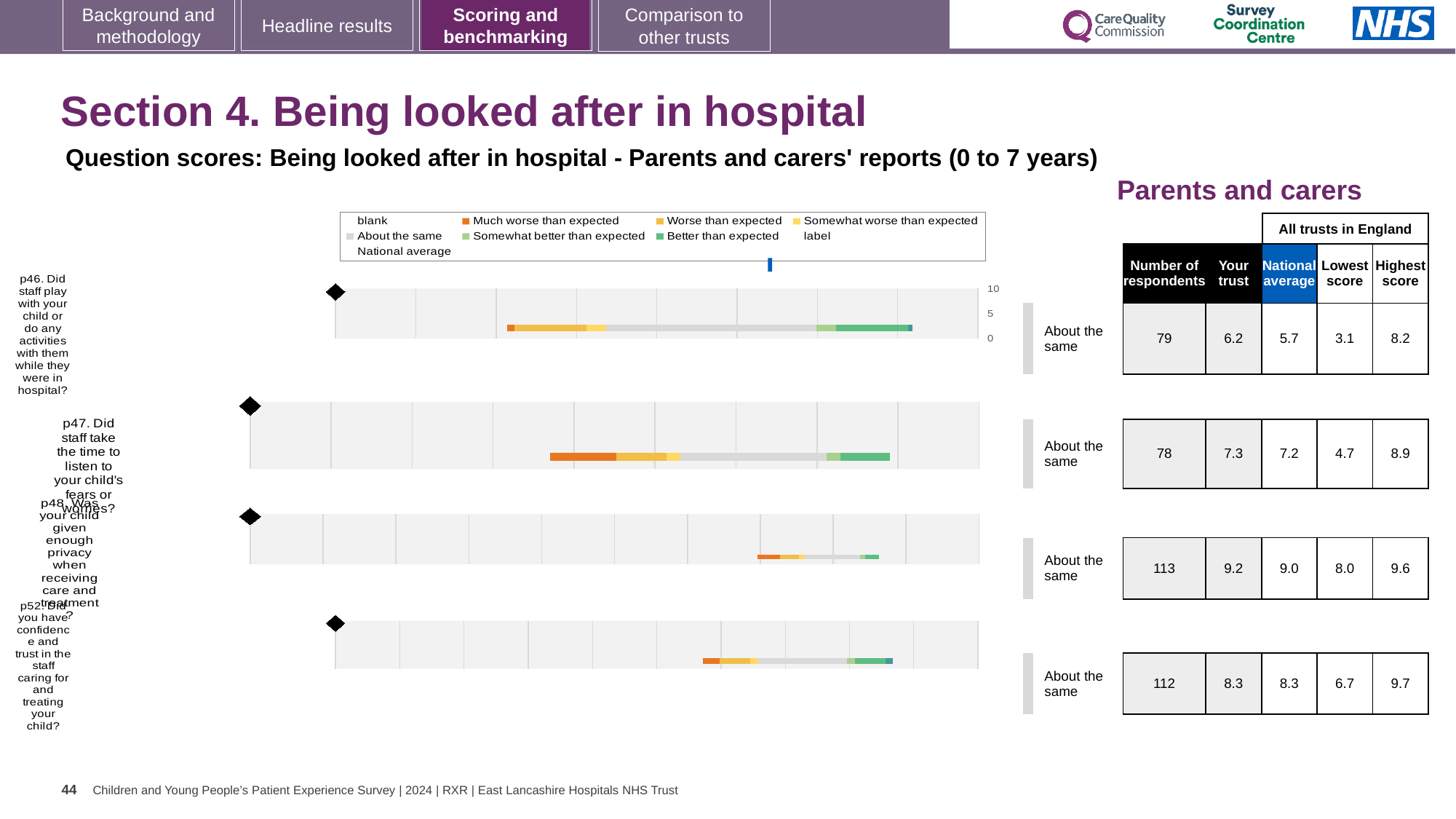
What kind of chart is used to show the question scores on this slide? bar chart What is the highest score among all trusts in England for p52 (Did you have confidence and trust in the staff caring for and treating your child?)? 9.7 For p46, which is larger: the 'Your trust' score or the national average? Your trust How many respondents answered p48 (Was your child given enough privacy when receiving care and treatment?)? 113 Which colour in the legend represents 'Much worse than expected'? orange Which question has the highest 'Your trust' score? p48 How many survey questions are plotted on the slide? 4 What is the difference between the highest score and the lowest score for p47? 4.2 What is the national average score for p47 (Did staff take the time to listen to your child's fears or worries?)? 7.2 What benchmark category is shown next to each of the four questions? About the same Which question has the lowest 'Your trust' score? p46 What is the 'Your trust' score for p46 (Did staff play with your child or do any activities with them while they were in hospital?)? 6.2